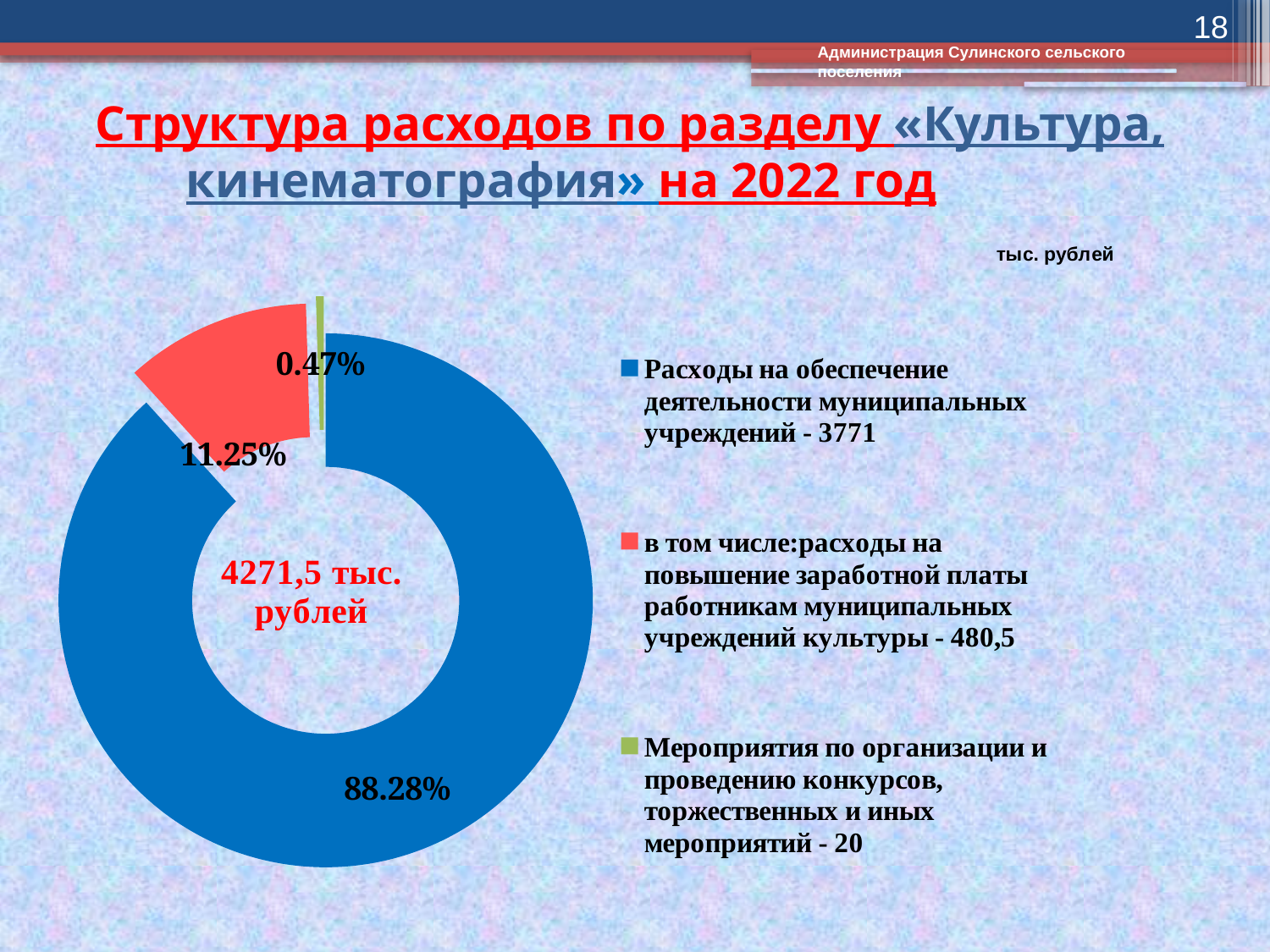
What value is given in the legend for Расходы на обеспечение деятельности муниципальных учреждений? 3771 Which category has the smallest slice of the doughnut chart? Мероприятия по организации и проведению конкурсов, торжественных и иных мероприятий What share of the doughnut chart is labelled for the green slice (Мероприятия по организации и проведению конкурсов, торжественных и иных мероприятий)? 0.47% What share of the doughnut chart is labelled for the red slice (расходы на повышение заработной платы работникам муниципальных учреждений культуры)? 11.25% How many slices does the doughnut chart have? 3 What value is given in the legend for расходы на повышение заработной платы работникам муниципальных учреждений культуры? 480,5 What share of the doughnut chart is labelled for the blue slice (Расходы на обеспечение деятельности муниципальных учреждений)? 88.28% What value is given in the legend for Мероприятия по организации и проведению конкурсов, торжественных и иных мероприятий? 20 What total amount is shown in the centre of the doughnut chart? 4271,5 тыс. рублей How many entries does the legend list? 3 What type of chart is shown on the slide? doughnut chart Which category has the largest slice of the doughnut chart? Расходы на обеспечение деятельности муниципальных учреждений